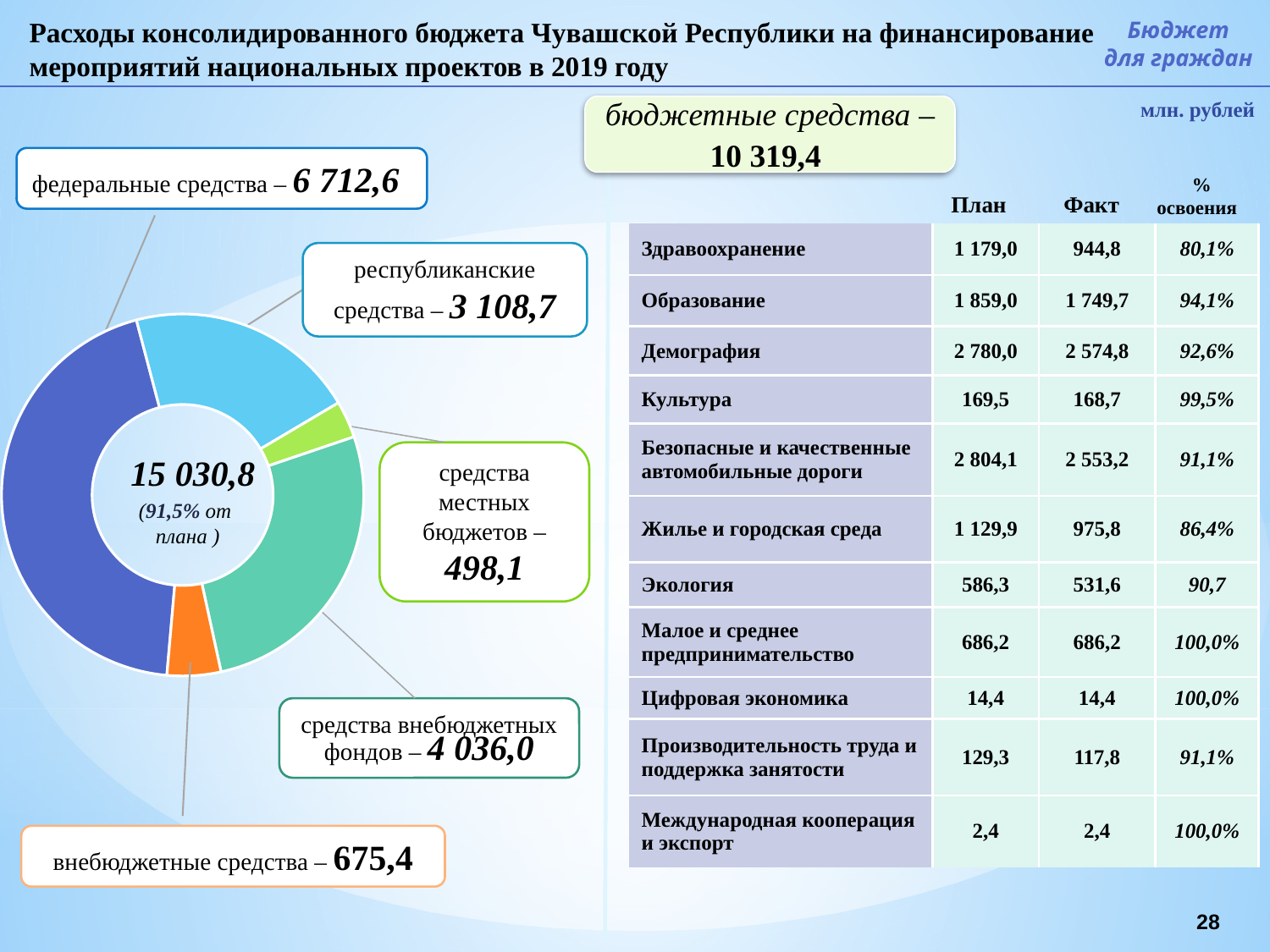
What is the value for республиканские средства in the donut chart? 3 108,7 What is the value for внебюджетные средства in the donut chart? 675,4 What is the difference between федеральные средства and республиканские средства in the donut chart? 3 603,9 What kind of chart is shown on the left of the slide? Donut (pie) chart What is the value for федеральные средства in the donut chart? 6 712,6 Which source has the smallest value in the donut chart? средства местных бюджетов How many segments does the donut chart have? 5 Which is larger in the donut chart: республиканские средства or средства внебюджетных фондов? средства внебюджетных фондов What is the value for средства внебюджетных фондов in the donut chart? 4 036,0 What is the value for средства местных бюджетов in the donut chart? 498,1 What total value is shown in the centre of the donut chart? 15 030,8 Which source has the largest value in the donut chart? федеральные средства